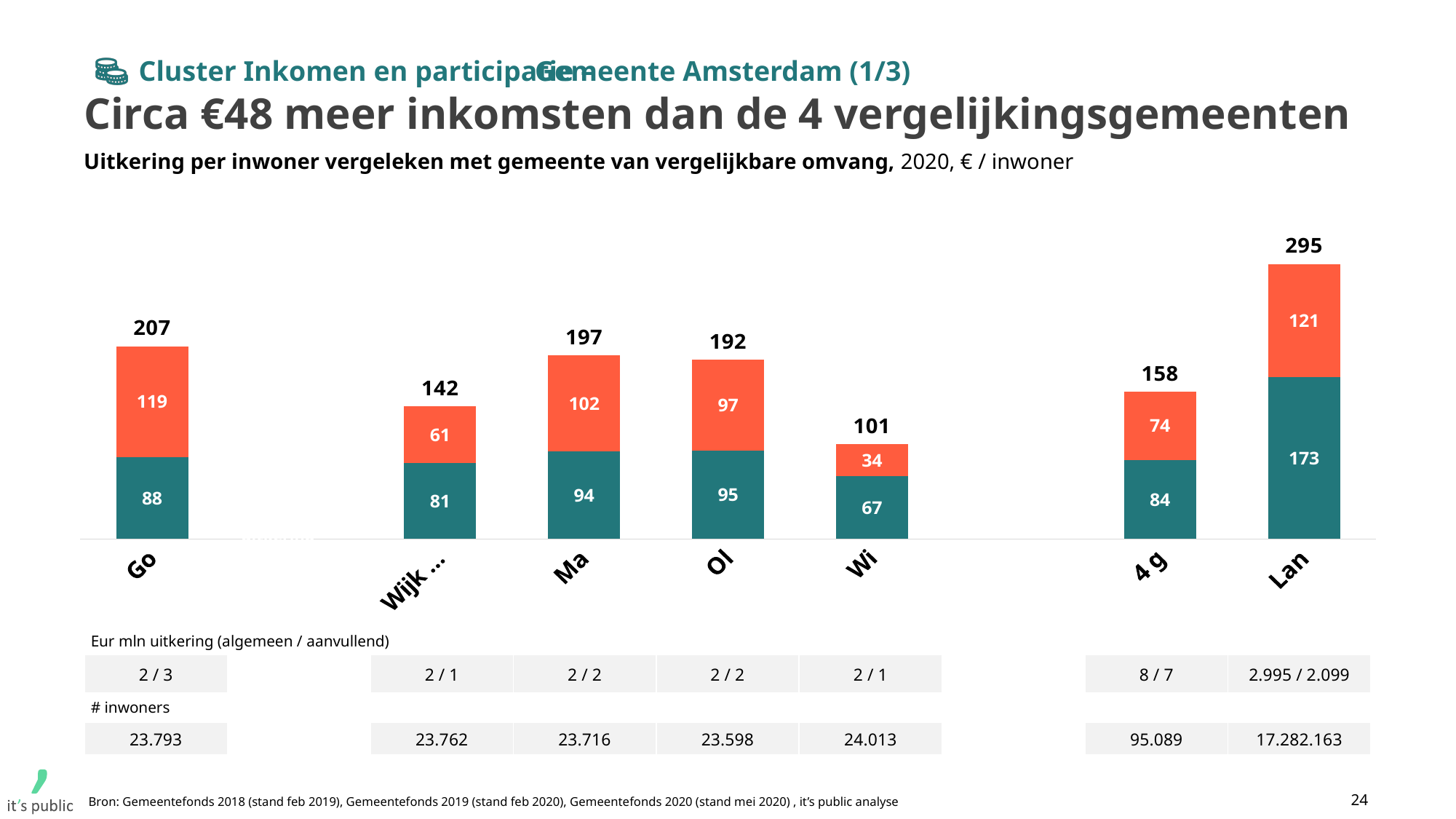
What is the value of the orange (top) segment of the bar for Ma? 102 What is the value of the orange (top) segment of the bar for Wi? 34 What is the number of inhabitants (# inwoners) listed under the Lan bar? 17.282.163 Which has a larger total value, Ma or Ol? Ma What is the value of the teal (bottom) segment of the bar for Go? 88 What is the total value shown above the bar for Lan? 295 Which category has the highest total value? Lan What is the total value shown above the bar for Wi? 101 What is the difference between the total for Go (207) and the total for 4 g (158)? 49 Which category has the lowest total value? Wi What kind of chart is shown on the slide? Stacked bar chart How many bars are shown in the chart? 7